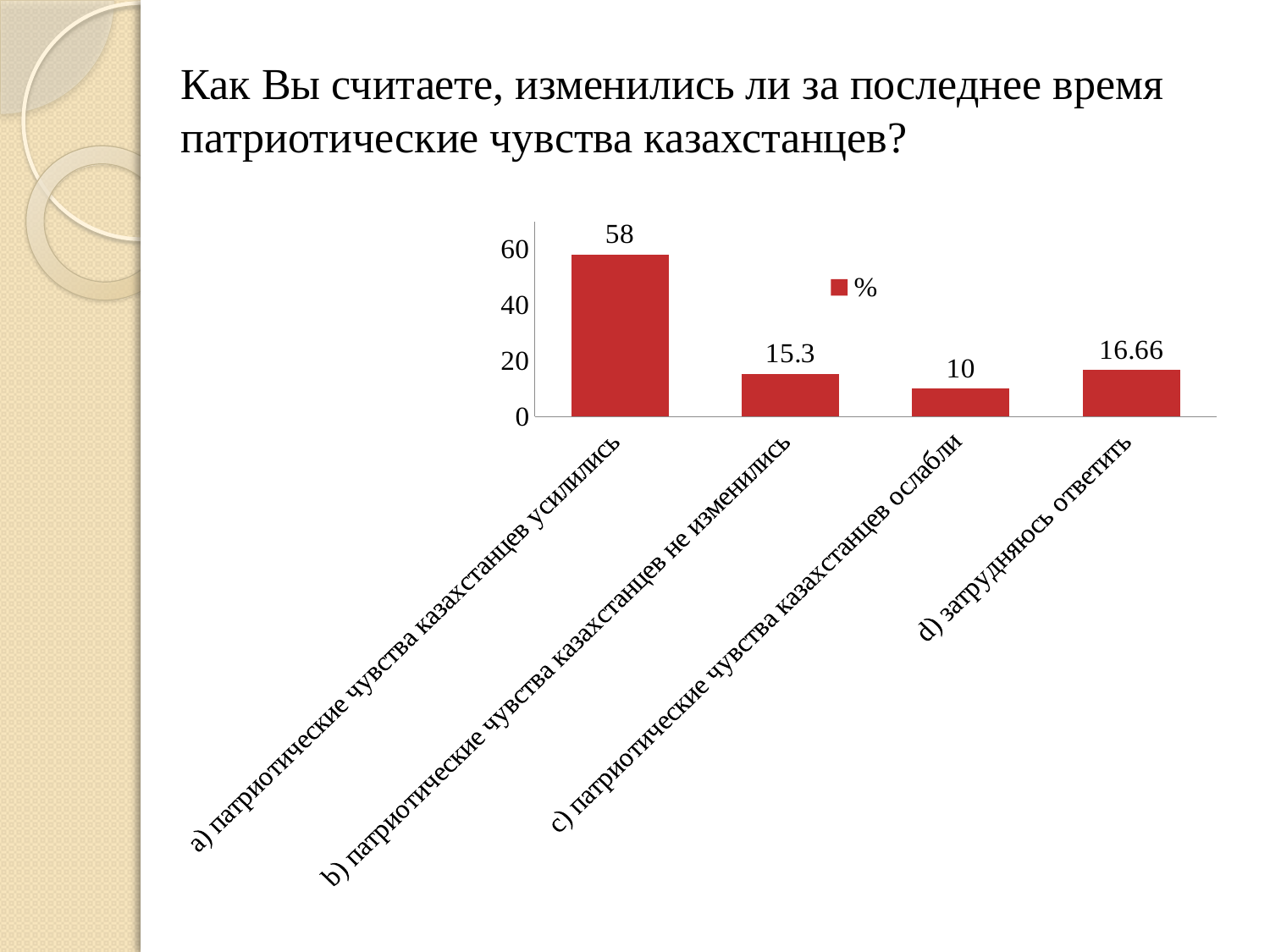
What value is shown for "c) патриотические чувства казахстанцев ослабли"? 10 How many categories are shown in the chart? 4 What value is shown for "b) патриотические чувства казахстанцев не изменились"? 15.3 Which is larger: the value for "b) патриотические чувства казахстанцев не изменились" or for "d) затрудняюсь ответить"? d) затрудняюсь ответить Which category has the lowest value? c) патриотические чувства казахстанцев ослабли What is the legend entry for the series in the chart? % Is the value for "a) патриотические чувства казахстанцев усилились" greater or less than 40? greater What is the difference between the values for "a) патриотические чувства казахстанцев усилились" and "c) патриотические чувства казахстанцев ослабли"? 48 What value is shown for "d) затрудняюсь ответить"? 16.66 What kind of chart is shown on the slide? bar chart What value is shown for "a) патриотические чувства казахстанцев усилились"? 58 Which category has the highest value? a) патриотические чувства казахстанцев усилились